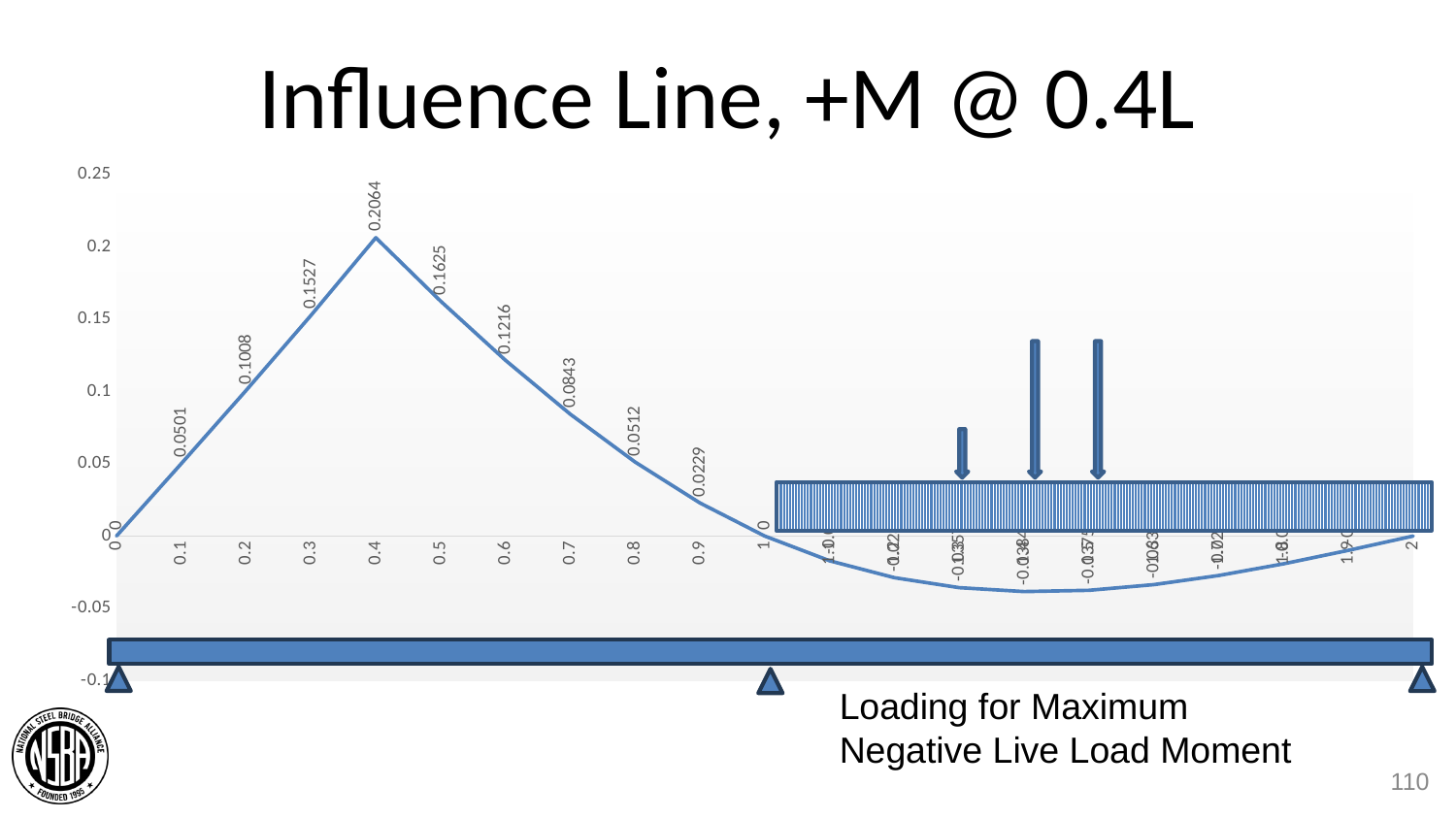
At which x position does the influence line reach its highest value? 0.4 What is the difference between the values at x = 0.4 and x = 0.5? 0.0439 Is the value of the influence line at x = 0.5 greater or less than 0.15? greater Between x = 0.4 and x = 1, do the values of the influence line rise or fall? fall What kind of chart is shown on the slide? line chart Which is larger, the value at x = 0.3 or the value at x = 0.6? x = 0.3 What is the value of the influence line at x = 0.4? 0.2064 What is the value of the influence line at x = 0.2? 0.1008 What is the title of the chart on the slide? Influence Line, +M @ 0.4L What is the difference between the values at x = 0.3 and x = 0.1? 0.1026 What is the value of the influence line at x = 0.9? 0.0229 What is the value of the influence line at x = 0.7? 0.0843